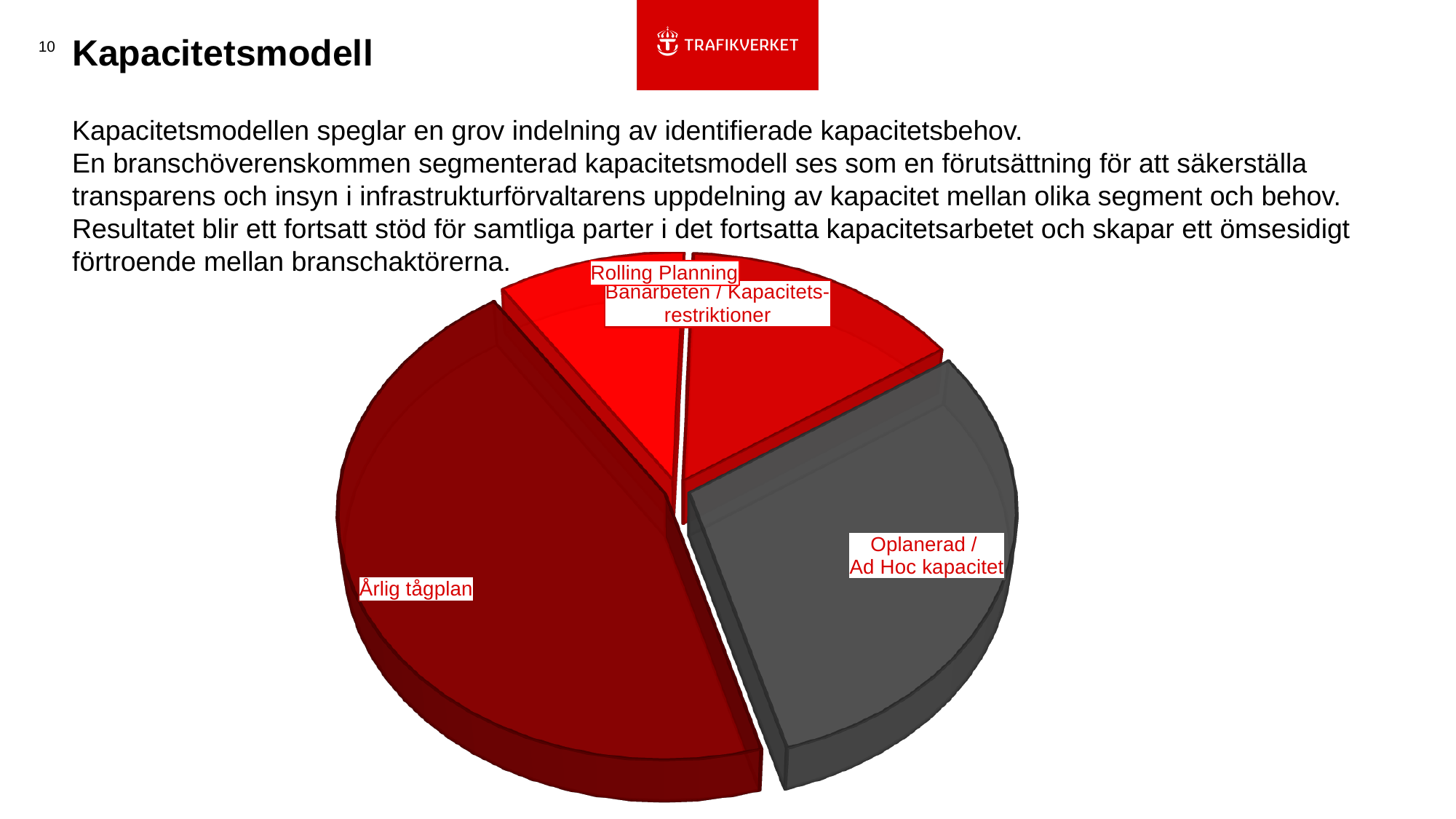
Which is larger in the pie chart, Årlig tågplan or Banarbeten / Kapacitetsrestriktioner? Årlig tågplan What colour is the Oplanerad / Ad Hoc kapacitet slice in the pie chart? grey Which is larger in the pie chart, Oplanerad / Ad Hoc kapacitet or Rolling Planning? Oplanerad / Ad Hoc kapacitet Which is larger in the pie chart, Årlig tågplan or Oplanerad / Ad Hoc kapacitet? Årlig tågplan What kind of chart is shown on the slide? pie chart Which slice of the pie chart is the largest? Årlig tågplan How many slices does the pie chart have? 4 What is the title of the slide containing the pie chart? Kapacitetsmodell